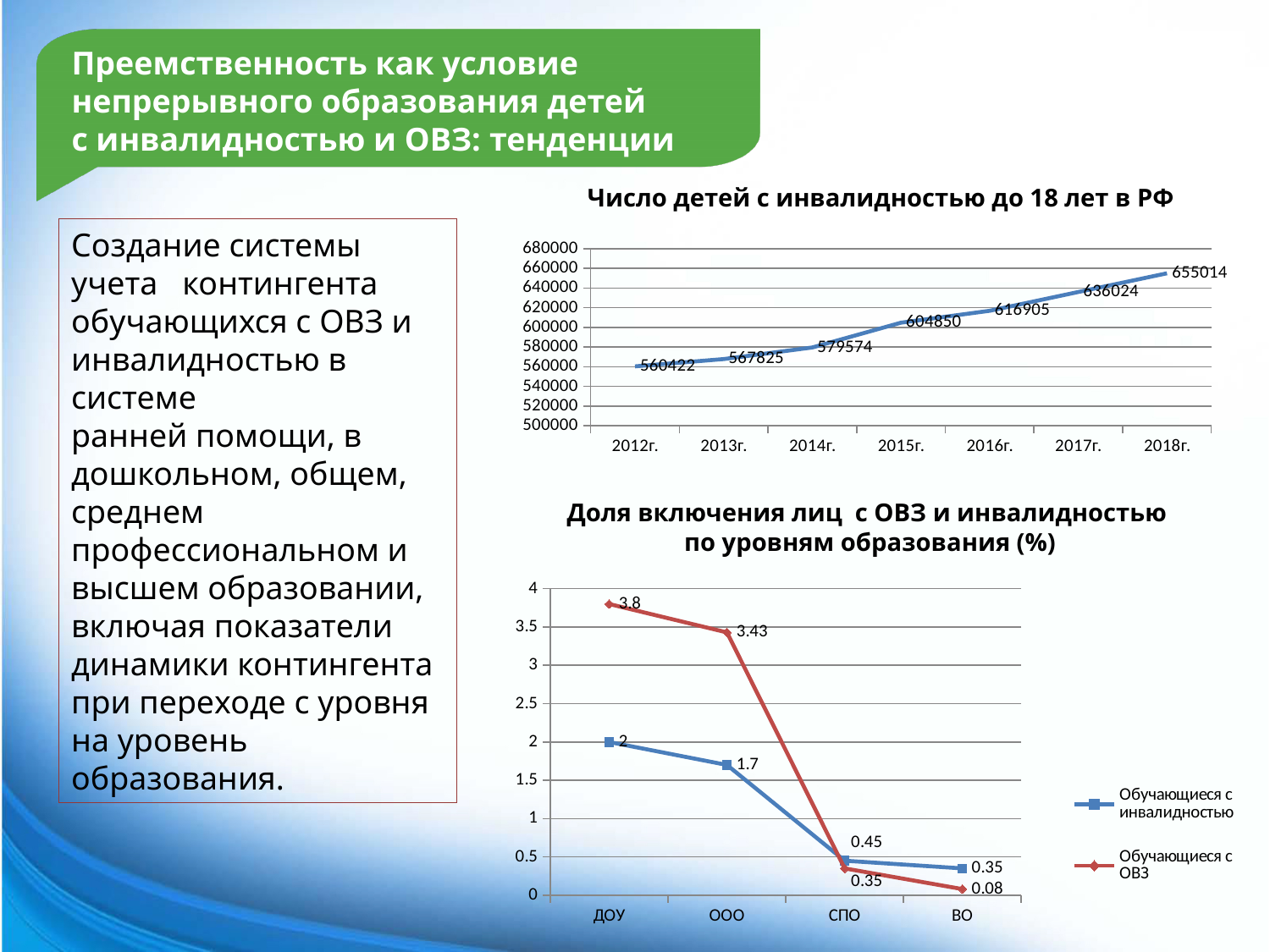
In the chart 'Доля включения лиц с ОВЗ и инвалидностью по уровням образования (%)', what is the value for 'Обучающиеся с ОВЗ' at ООО? 3.43 In the chart 'Доля включения лиц с ОВЗ и инвалидностью по уровням образования (%)', which series has the larger value at ДОУ? Обучающиеся с ОВЗ How many years are plotted in the chart 'Число детей с инвалидностью до 18 лет в РФ'? 7 In the chart 'Доля включения лиц с ОВЗ и инвалидностью по уровням образования (%)', what is the difference between the 'Обучающиеся с ОВЗ' values at ДОУ and ВО? 3.72 In the chart 'Доля включения лиц с ОВЗ и инвалидностью по уровням образования (%)', what is the value for 'Обучающиеся с инвалидностью' at ВО? 0.35 In the chart 'Число детей с инвалидностью до 18 лет в РФ', what is the value for 2012г.? 560422 What kind of chart is 'Число детей с инвалидностью до 18 лет в РФ'? line chart In the chart 'Число детей с инвалидностью до 18 лет в РФ', do the values rise or fall from 2012г. to 2018г.? rise In the chart 'Доля включения лиц с ОВЗ и инвалидностью по уровням образования (%)', how many series does the legend list? 2 In the chart 'Число детей с инвалидностью до 18 лет в РФ', which year has the highest value? 2018г. In the chart 'Число детей с инвалидностью до 18 лет в РФ', what is the value for 2015г.? 604850 In the chart 'Число детей с инвалидностью до 18 лет в РФ', what is the difference between the values for 2018г. and 2017г.? 18990